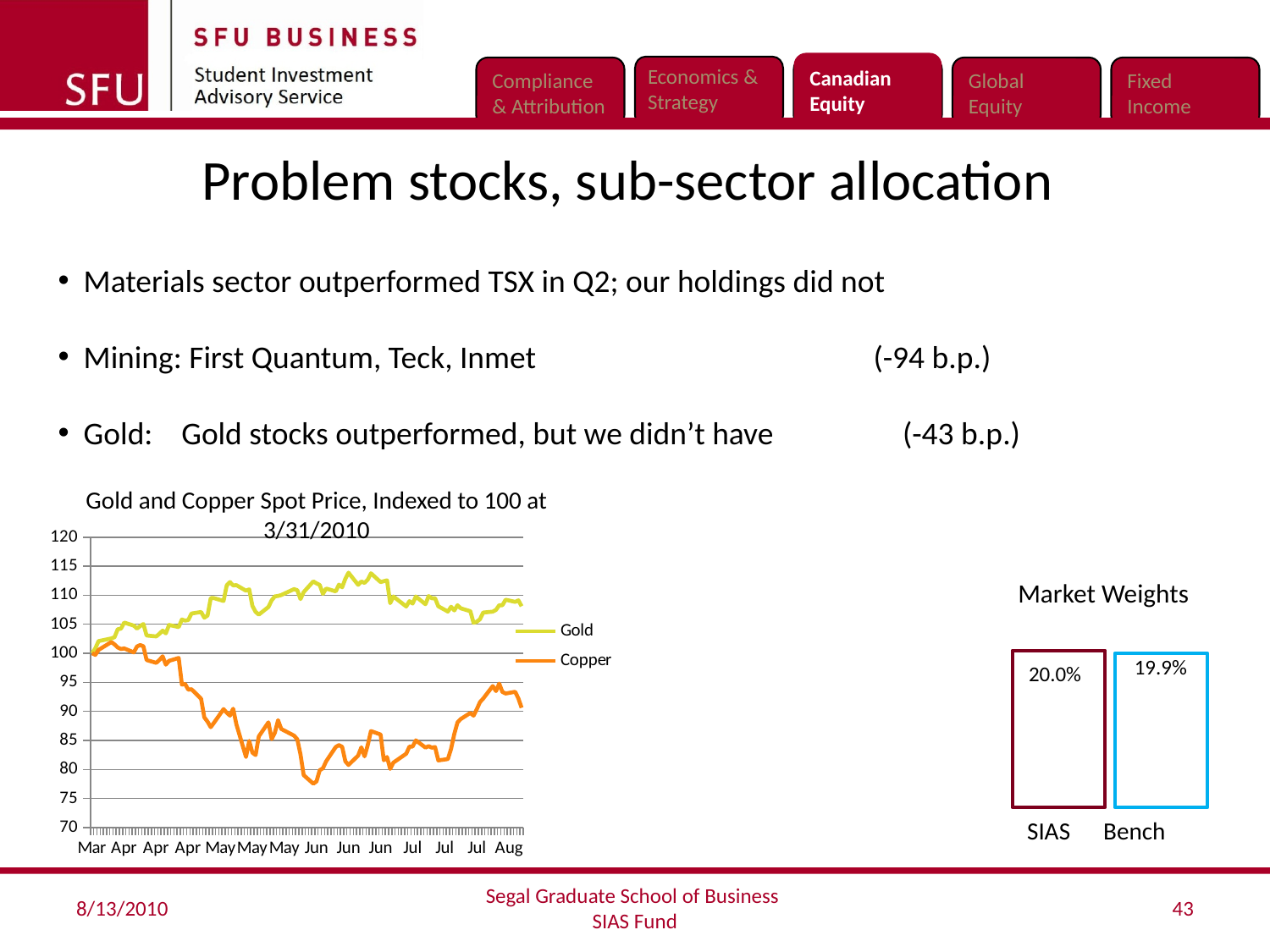
What kind of chart is the Gold and Copper Spot Price chart? Line chart How many bars are shown in the Market Weights chart? 2 How many series does the legend of the Gold and Copper Spot Price chart list? 2 In the Gold and Copper Spot Price chart, does the Copper series generally rise or fall from March to August? Fall In the Market Weights chart, what is the value for Bench? 19.9% In the Market Weights chart, what is the value for SIAS? 20.0% In the Market Weights chart, what is the difference between the SIAS and Bench values? 0.1% In the Gold and Copper Spot Price chart, is the lowest value of the Copper series greater or less than 80? less In the Gold and Copper Spot Price chart, does the Gold series generally rise or fall from March to August? Rise In the Gold and Copper Spot Price chart, which series is higher at the end of the period (Aug), Gold or Copper? Gold In the Market Weights chart, which is larger, SIAS or Bench? SIAS What kind of chart is the Market Weights chart? Bar chart